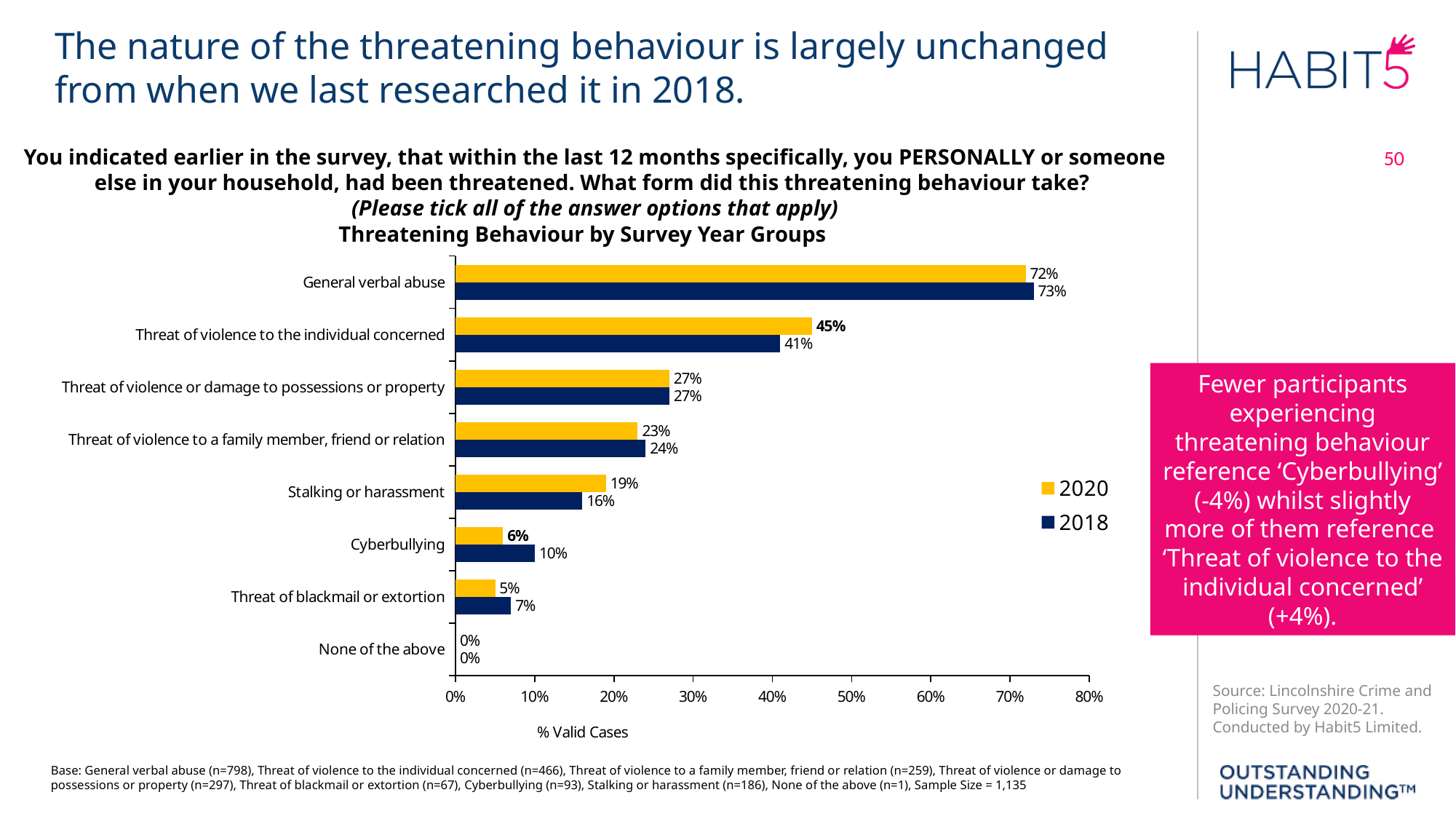
What kind of chart is shown on the slide? Bar chart Which is larger for Threat of blackmail or extortion, the 2020 value or the 2018 value? 2018 What is the label on the horizontal axis of the chart? % Valid Cases What is the 2020 value for General verbal abuse? 72% How many categories are shown on the chart? 8 What is the 2018 value for Stalking or harassment? 16% Which category has the lowest 2020 value? None of the above What is the 2018 value for Threat of violence to the individual concerned? 41% What is the difference between the 2020 and 2018 values for Cyberbullying? 4% What is the 2020 value for Cyberbullying? 6% How many series does the legend list? 2 Which category has the highest 2018 value? General verbal abuse